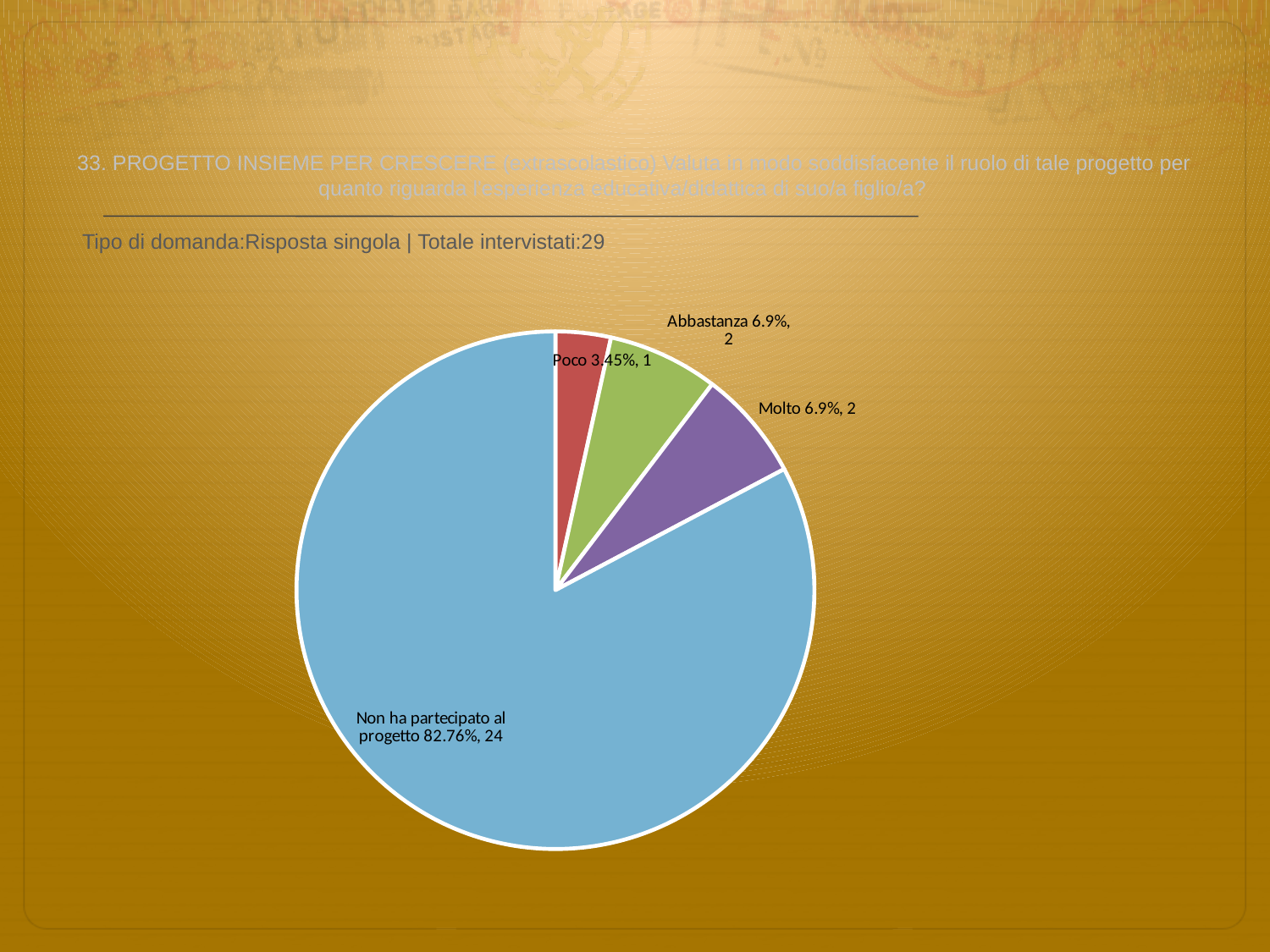
What percentage share does the 'Non ha partecipato al progetto' slice have? 82.76% What percentage share does the 'Molto' slice have? 6.9% How many respondents chose 'Non ha partecipato al progetto'? 24 What is the difference in number of respondents between 'Non ha partecipato al progetto' and 'Molto'? 22 What is the total number of respondents (Totale intervistati) stated on the slide? 29 What kind of chart is shown on the slide? pie chart What percentage share does the 'Poco' slice have? 3.45% How many slices does the pie chart have? 4 Which has more respondents, 'Abbastanza' or 'Poco'? Abbastanza How many respondents chose 'Abbastanza'? 2 Which category has the smallest slice of the pie? Poco Which category has the largest slice of the pie? Non ha partecipato al progetto